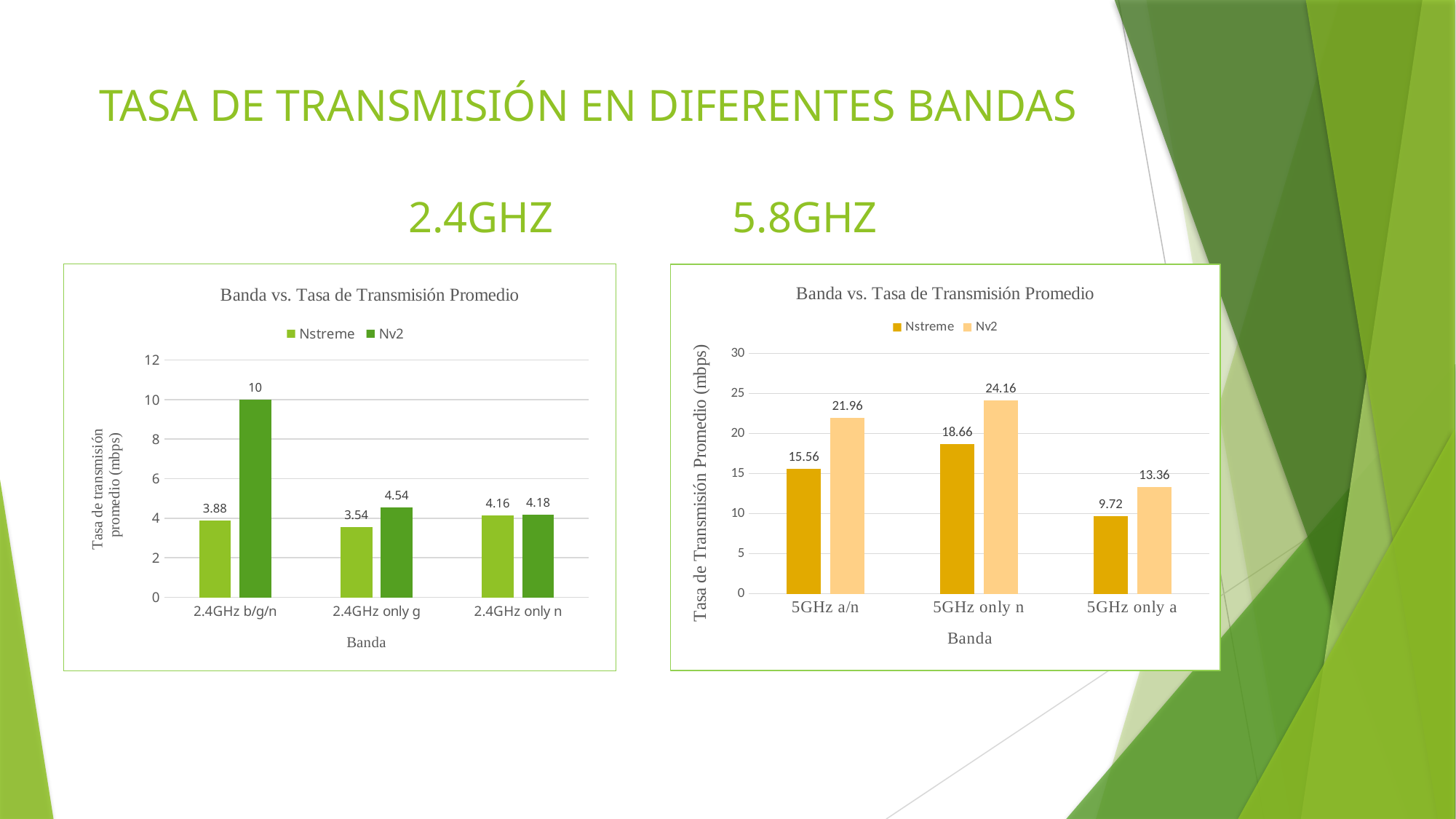
In the left (2.4GHz) chart, which category has the highest Nv2 value? 2.4GHz b/g/n In the left (2.4GHz) chart, what is the Nv2 value for 2.4GHz b/g/n? 10 In the left (2.4GHz) chart, what is the difference between the Nv2 and Nstreme values for 2.4GHz b/g/n? 6.12 In the left (2.4GHz) chart, what is the Nstreme value for 2.4GHz only g? 3.54 In the right (5.8GHz) chart, what is the Nv2 value for 5GHz only n? 24.16 In the right (5.8GHz) chart, what is the Nstreme value for 5GHz only a? 9.72 In the right (5.8GHz) chart, which category has the lowest Nstreme value? 5GHz only a In the right (5.8GHz) chart, which is larger for 5GHz only n: Nstreme or Nv2? Nv2 What type of chart is the left (2.4GHz) chart? Bar chart In the right (5.8GHz) chart, what is the difference between the Nv2 and Nstreme values for 5GHz a/n? 6.4 How many categories are shown on the x axis of the right (5.8GHz) chart? 3 How many series does the legend of the left (2.4GHz) chart list? 2